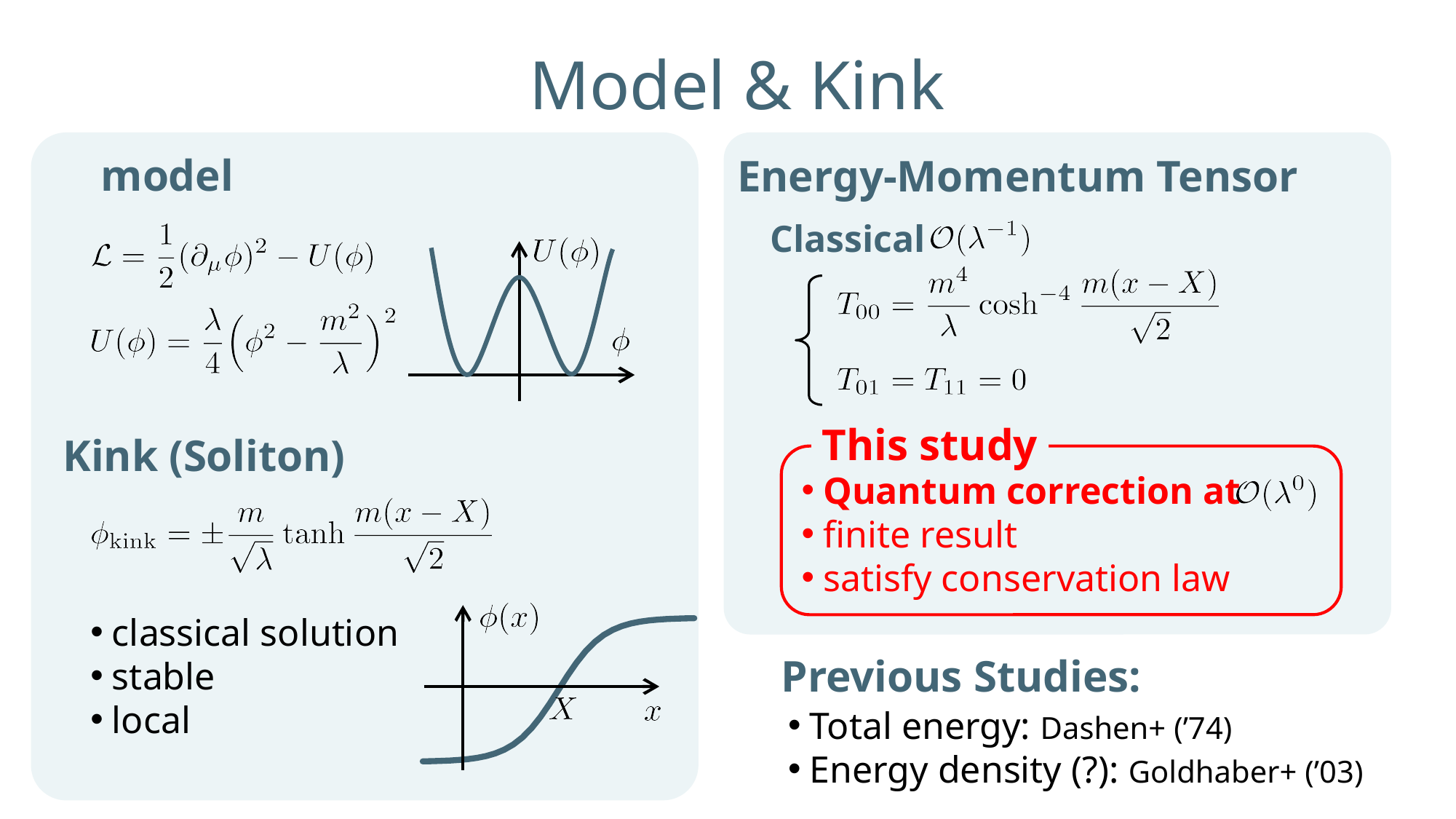
What label marks the point on the horizontal axis where the curve in the φ(x) plot crosses zero? X What is the vertical axis label of the plot in the model section? U(φ) In the φ(x) plot in the lower left, does the curve rise or fall as x increases? rise What kind of chart is the plot of φ(x) in the lower left of the slide? line chart In the U(φ) plot, is the value of U at φ = 0 greater or less than its value at the two minima? greater How many plots are shown on the slide? 2 How many minima does the U(φ) curve in the model section have? 2